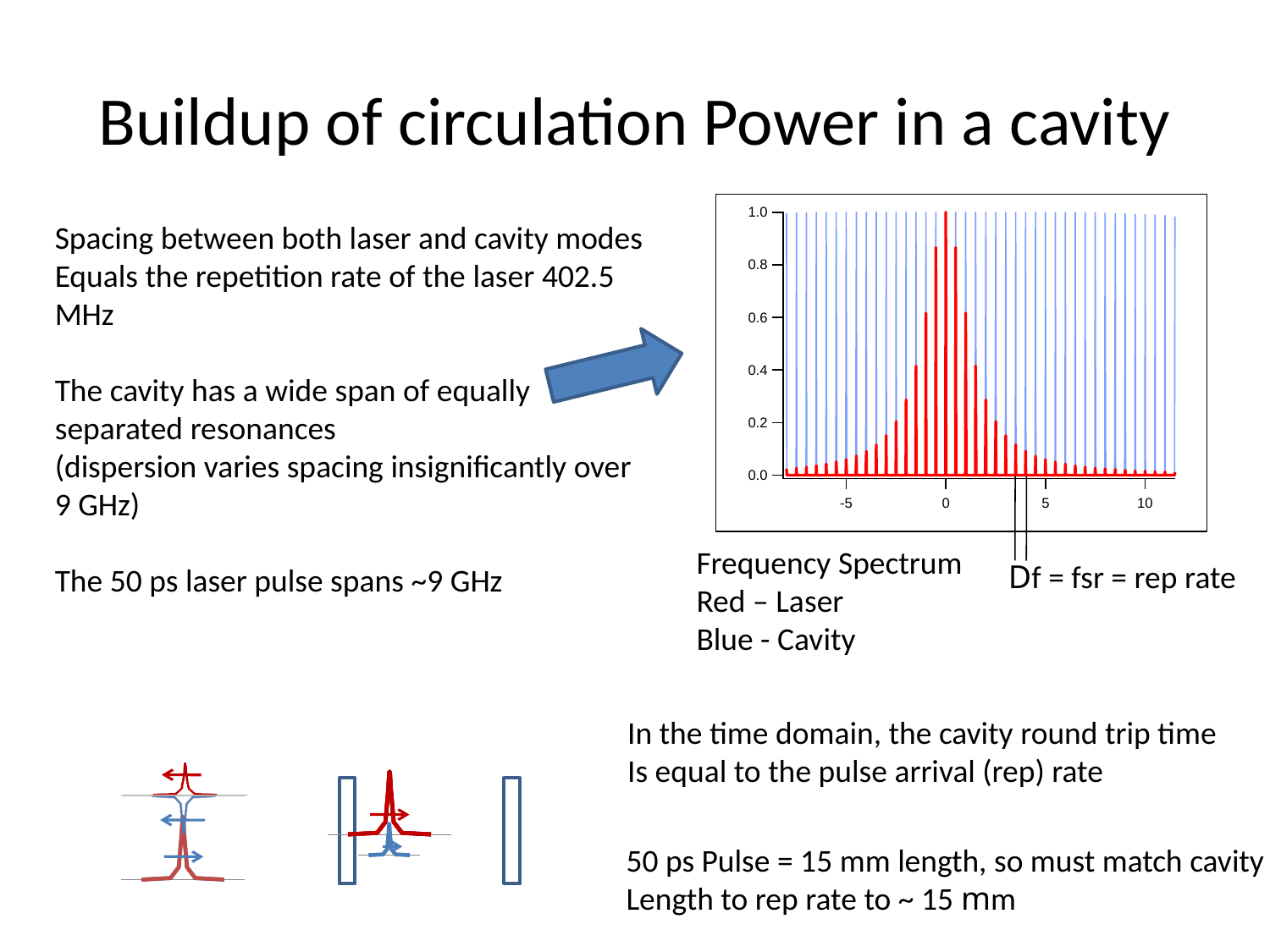
In the Frequency Spectrum chart, at which x-axis value does the red laser spectrum reach its highest peak? 0 In the Frequency Spectrum chart, what does the red series represent? Laser In the Frequency Spectrum chart, is the red laser value at x = 5 greater or less than 0.2? less In the Frequency Spectrum chart, is the red laser value at x = 10 greater or less than 0.2? less In the Frequency Spectrum chart, are the blue cavity peaks near x = 10 greater or less than 0.8? greater In the Frequency Spectrum chart, what does the blue series represent? Cavity In the Frequency Spectrum chart, which series spans the wider frequency range, red (laser) or blue (cavity)? blue (cavity) In the Frequency Spectrum chart, do the red laser peaks rise or fall as x increases from 0 to 10? fall In the Frequency Spectrum chart, do the red laser peaks rise or fall as x increases from -5 to 0? rise In the Frequency Spectrum chart, which is larger: the red laser peak at x = 0 or the red laser peak at x = 5? x = 0